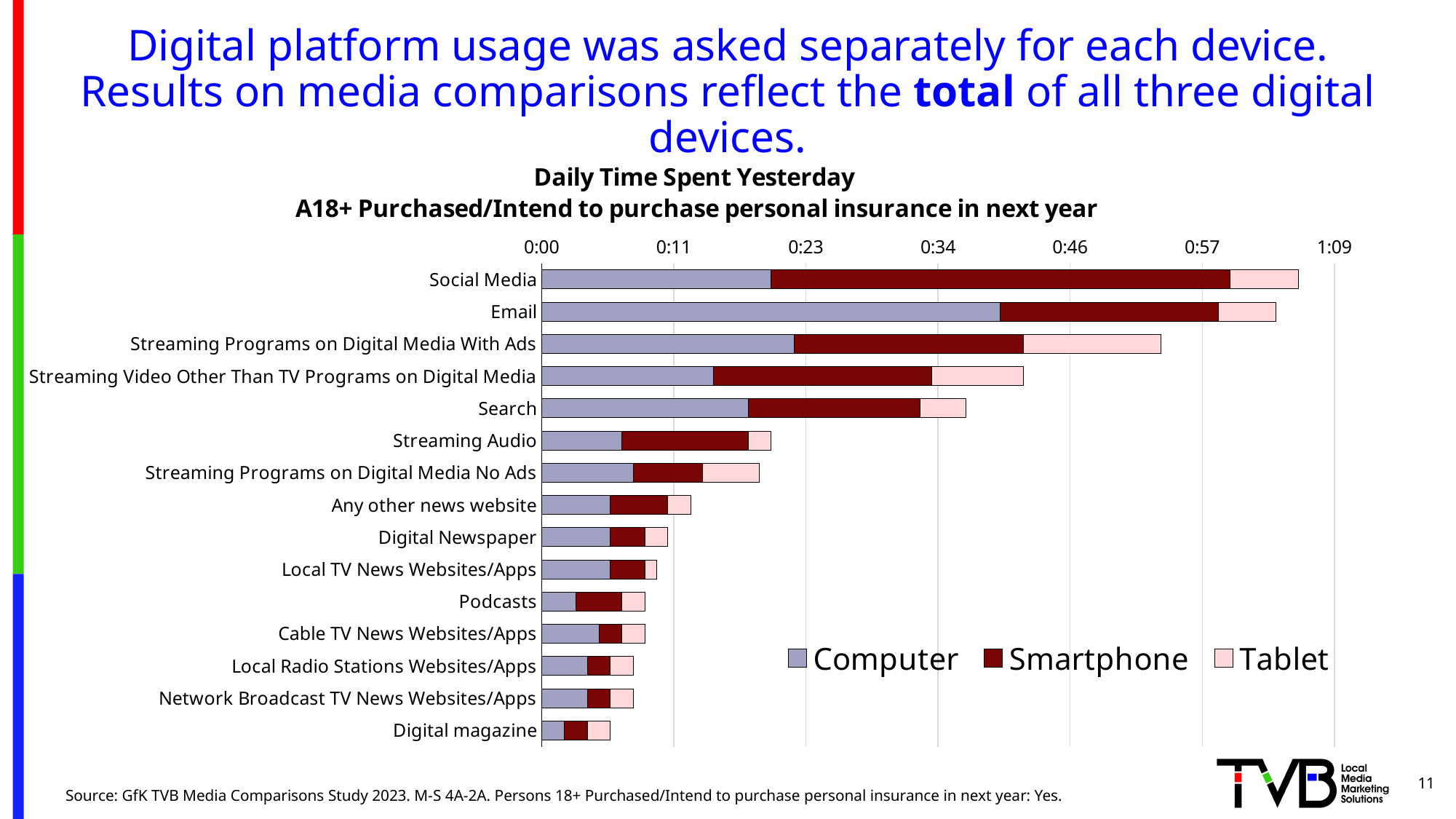
Is the total daily time spent for Digital magazine greater or less than 0:11? less How many series does the legend list? 3 Which platform has the shortest total bar for daily time spent? Digital magazine Is the total daily time spent for Streaming Programs on Digital Media With Ads greater or less than 0:46? greater Is the total daily time spent for Social Media greater or less than 0:57? greater Which has a larger total daily time spent, Search or Podcasts? Search Which series is shown in dark red in the legend? Smartphone How many categories (digital platforms) are plotted on the chart? 15 Which platform has the longest total bar for daily time spent? Social Media What kind of chart is shown on the slide? Stacked bar chart Which has a larger Computer segment, Email or Social Media? Email